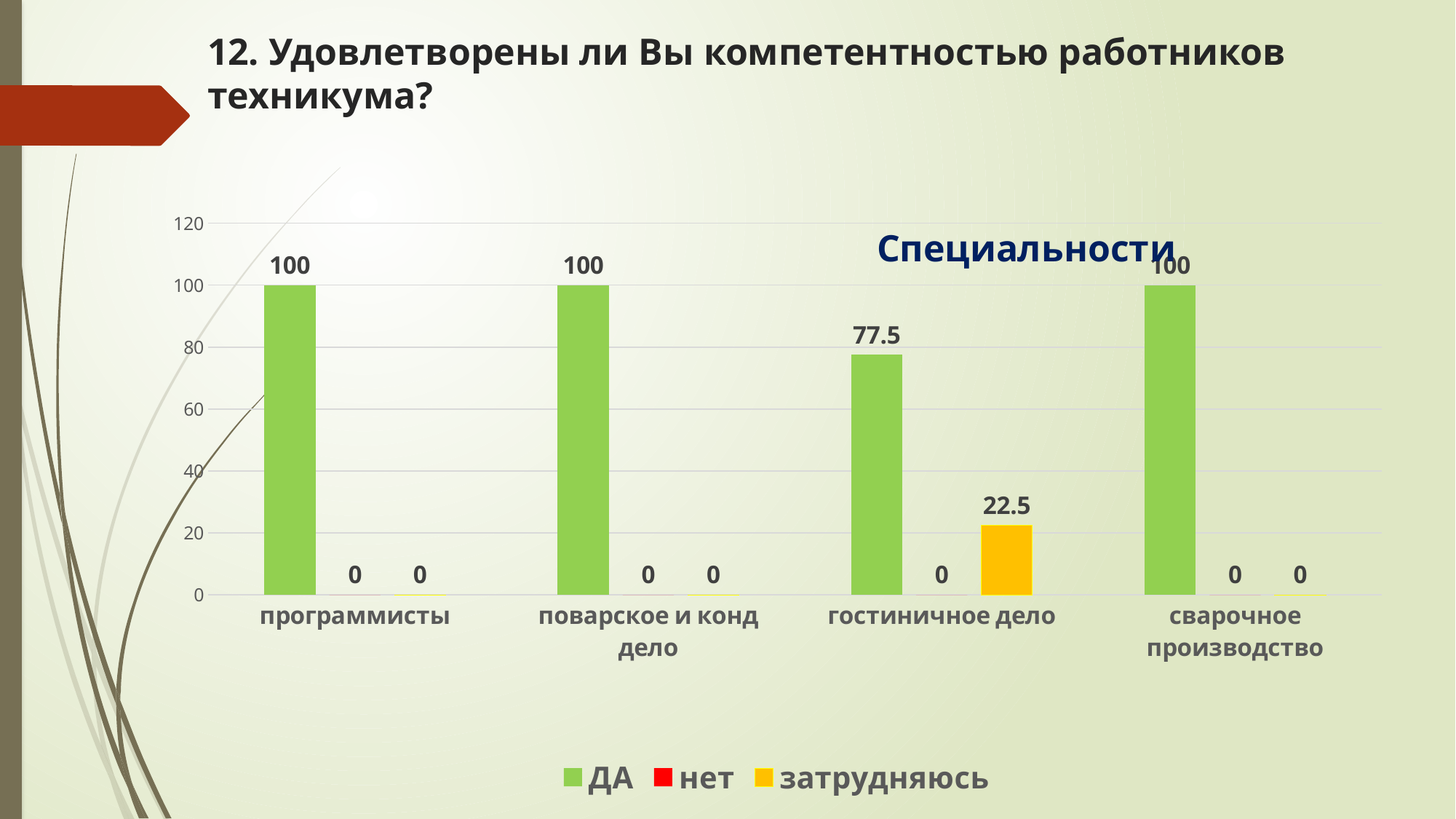
What colour represents the series затрудняюсь in the legend? yellow What is the value of ДА for программисты? 100 What is the value of ДА for гостиничное дело? 77.5 What is the difference between the ДА value for поварское и конд дело and the ДА value for гостиничное дело? 22.5 How many categories are shown on the x axis? 4 What is the value of нет for сварочное производство? 0 Which is larger for гостиничное дело: ДА or затрудняюсь? ДА Which category has the highest value for затрудняюсь? гостиничное дело What is the value of затрудняюсь for гостиничное дело? 22.5 What kind of chart is shown on the slide? bar chart How many series does the legend list? 3 Which category has the lowest value for ДА? гостиничное дело